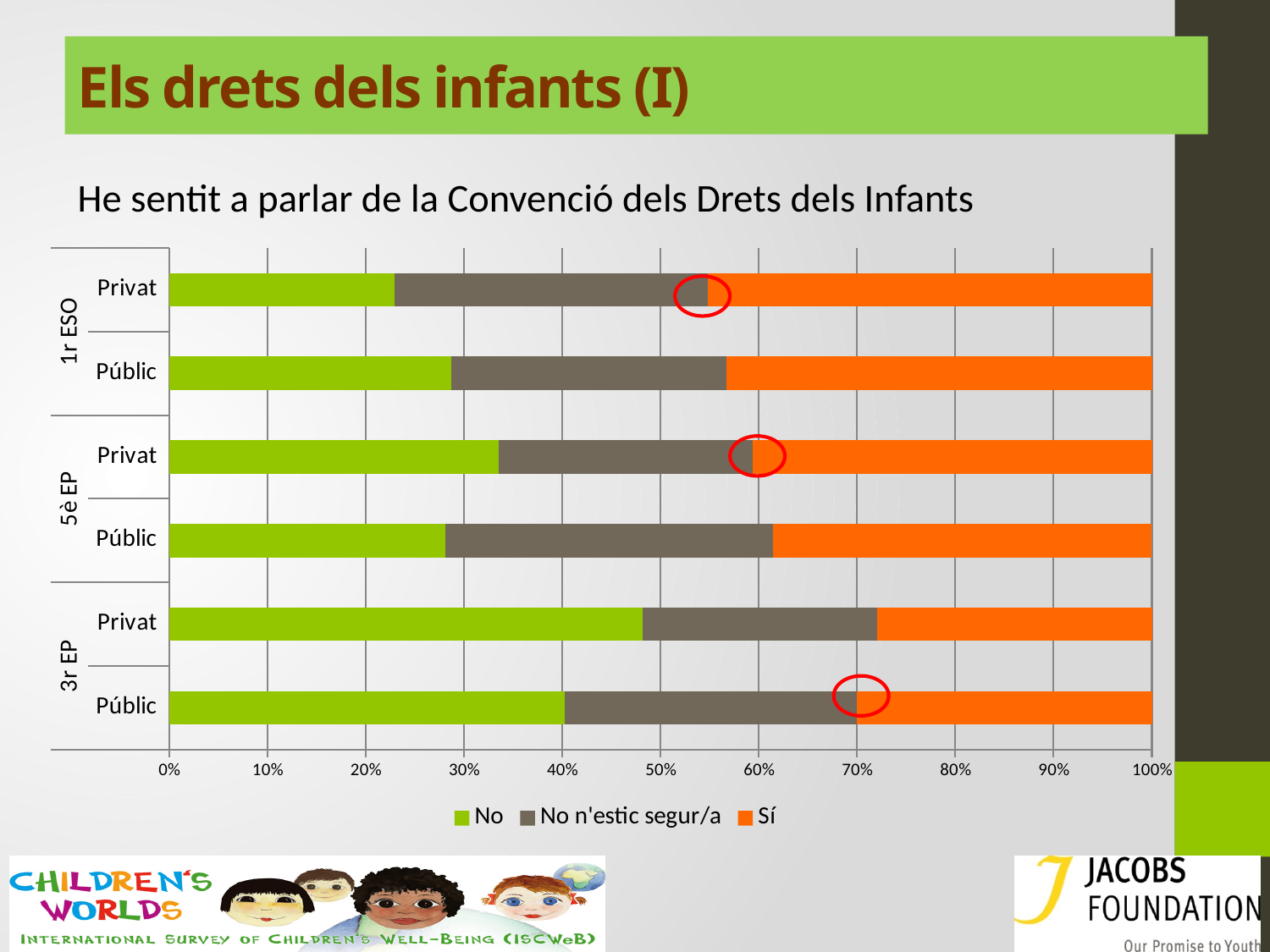
What kind of chart is shown on the slide? Stacked bar chart Is the 'No' share for 5è EP Privat greater or less than 30%? greater How many series does the legend list? 3 What is the title shown above the chart? He sentit a parlar de la Convenció dels Drets dels Infants Which has a larger 'No' share, 3r EP Privat or 1r ESO Privat? 3r EP Privat Is the 'No' share for 3r EP Privat greater or less than 50%? less Which group has the smallest 'No' share? 1r ESO Privat Which group has the largest 'No' share? 3r EP Privat What are the three legend entries of the chart? No, No n'estic segur/a, Sí Which group has the largest 'Sí' share? 1r ESO Privat How many bars are plotted in the chart? 6 Is the 'No' share for 1r ESO Privat greater or less than 20%? greater